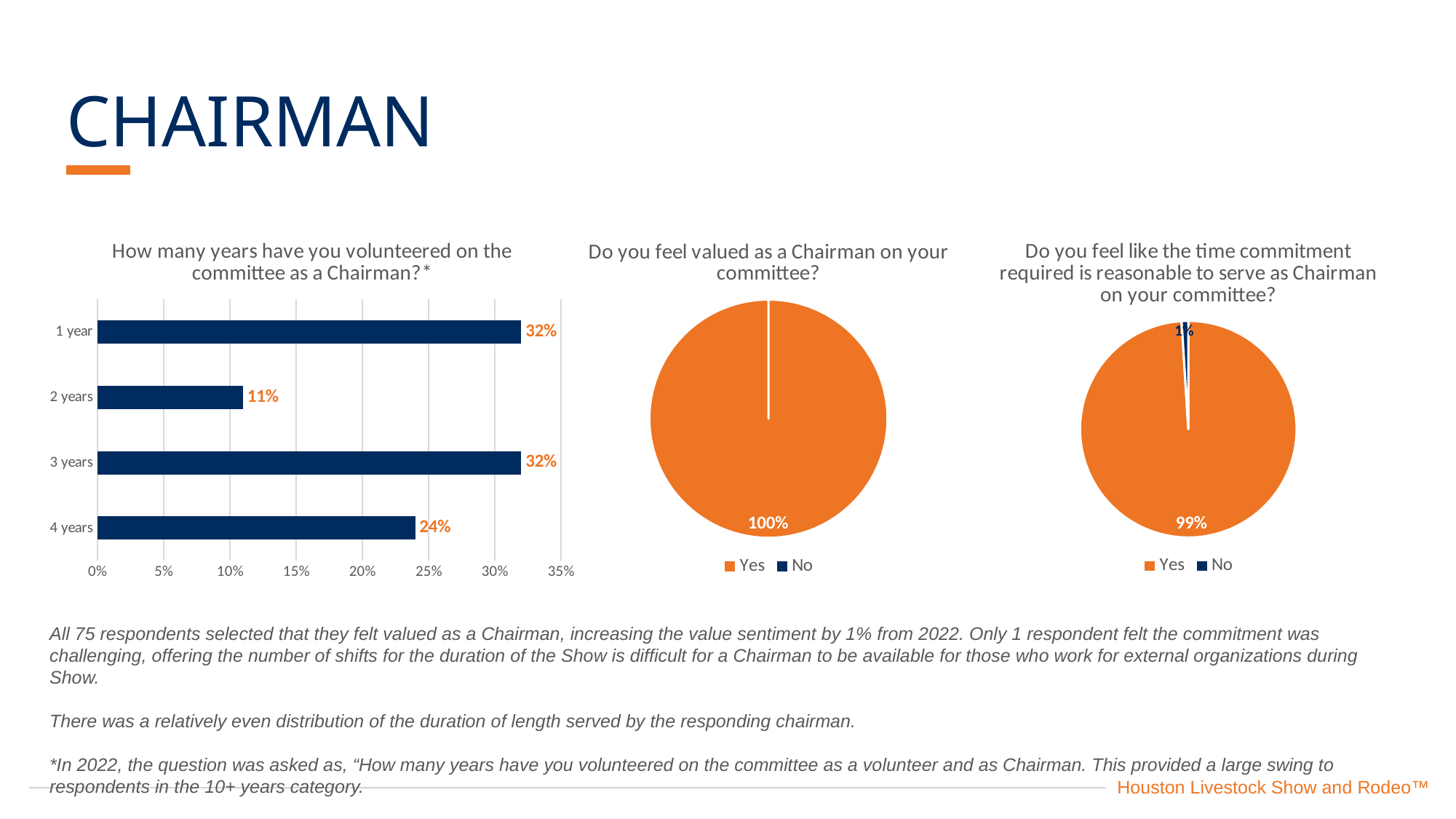
In the 'How many years have you volunteered on the committee as a Chairman?' chart, how many categories are shown? 4 What kind of chart is the 'How many years have you volunteered on the committee as a Chairman?' chart? Bar chart In the 'How many years have you volunteered on the committee as a Chairman?' chart, what is the value for 2 years? 11% In the 'How many years have you volunteered on the committee as a Chairman?' chart, what is the difference between the values for 1 year and 2 years? 21% In the 'Do you feel valued as a Chairman on your committee?' chart, what share of the pie is Yes? 100% In the 'Do you feel like the time commitment required is reasonable to serve as Chairman on your committee?' chart, what share of the pie is Yes? 99% What kind of chart is the 'Do you feel like the time commitment required is reasonable to serve as Chairman on your committee?' chart? Pie chart In the 'How many years have you volunteered on the committee as a Chairman?' chart, which category has the lowest value? 2 years In the 'Do you feel like the time commitment required is reasonable to serve as Chairman on your committee?' chart, what share of the pie is No? 1% In the 'How many years have you volunteered on the committee as a Chairman?' chart, what is the value for 4 years? 24% How many series does the legend list in the 'Do you feel valued as a Chairman on your committee?' chart? 2 In the 'How many years have you volunteered on the committee as a Chairman?' chart, which is larger, the value for 4 years or the value for 2 years? 4 years